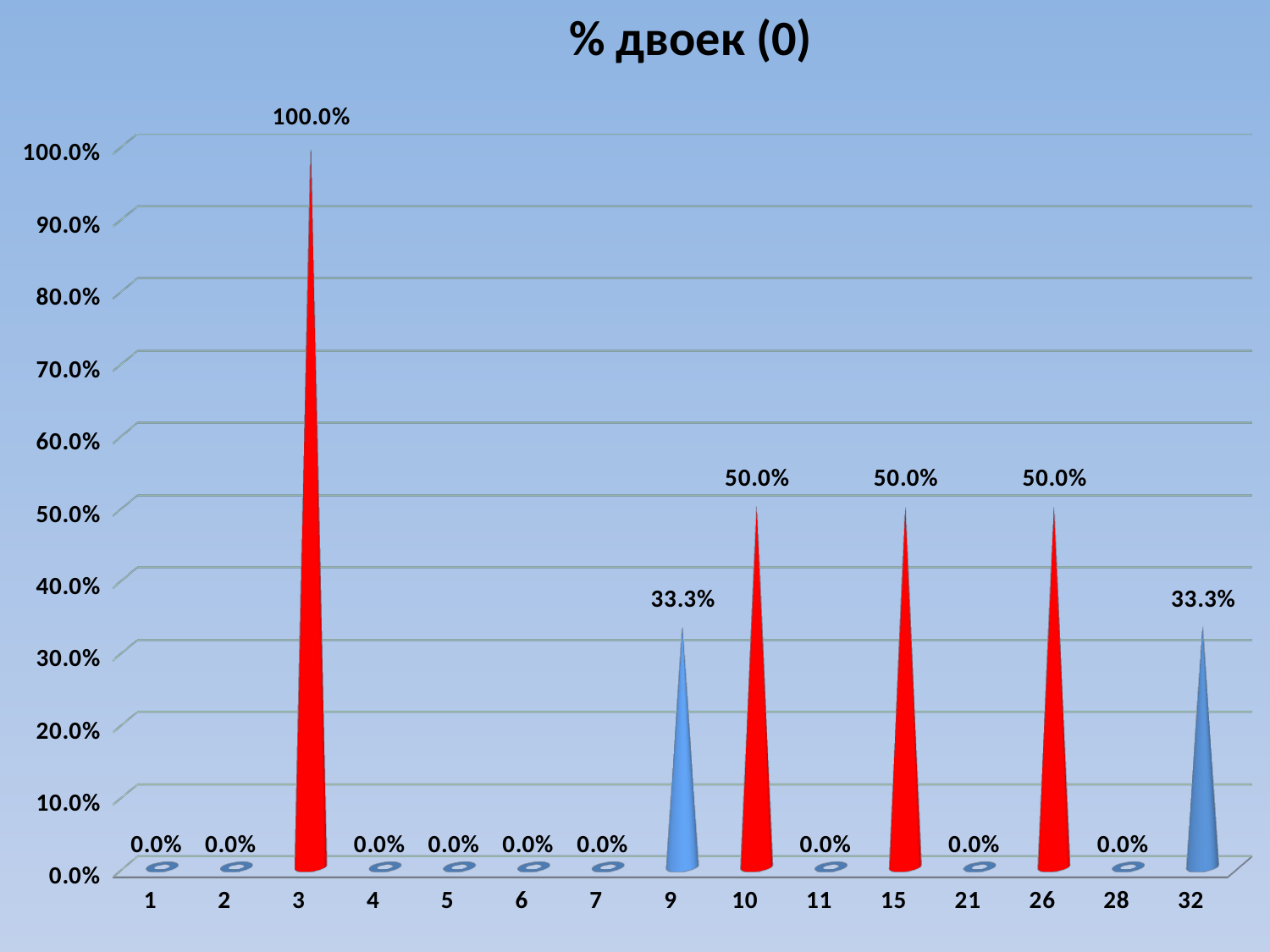
Which category has the highest value? 3 What is the value for category 3? 100.0% What is the title of the chart? % двоек (0) What is the difference between the values for category 3 and category 10? 50.0% Which is larger, the value for category 10 or the value for category 32? 10 What is the difference between the values for category 15 and category 32? 16.7% What colour are the bars for categories 3, 10, 15 and 26? red How many categories are shown on the x axis? 15 What is the value for category 26? 50.0% What kind of chart is this? bar chart What is the value for category 9? 33.3% What is the value for category 28? 0.0%